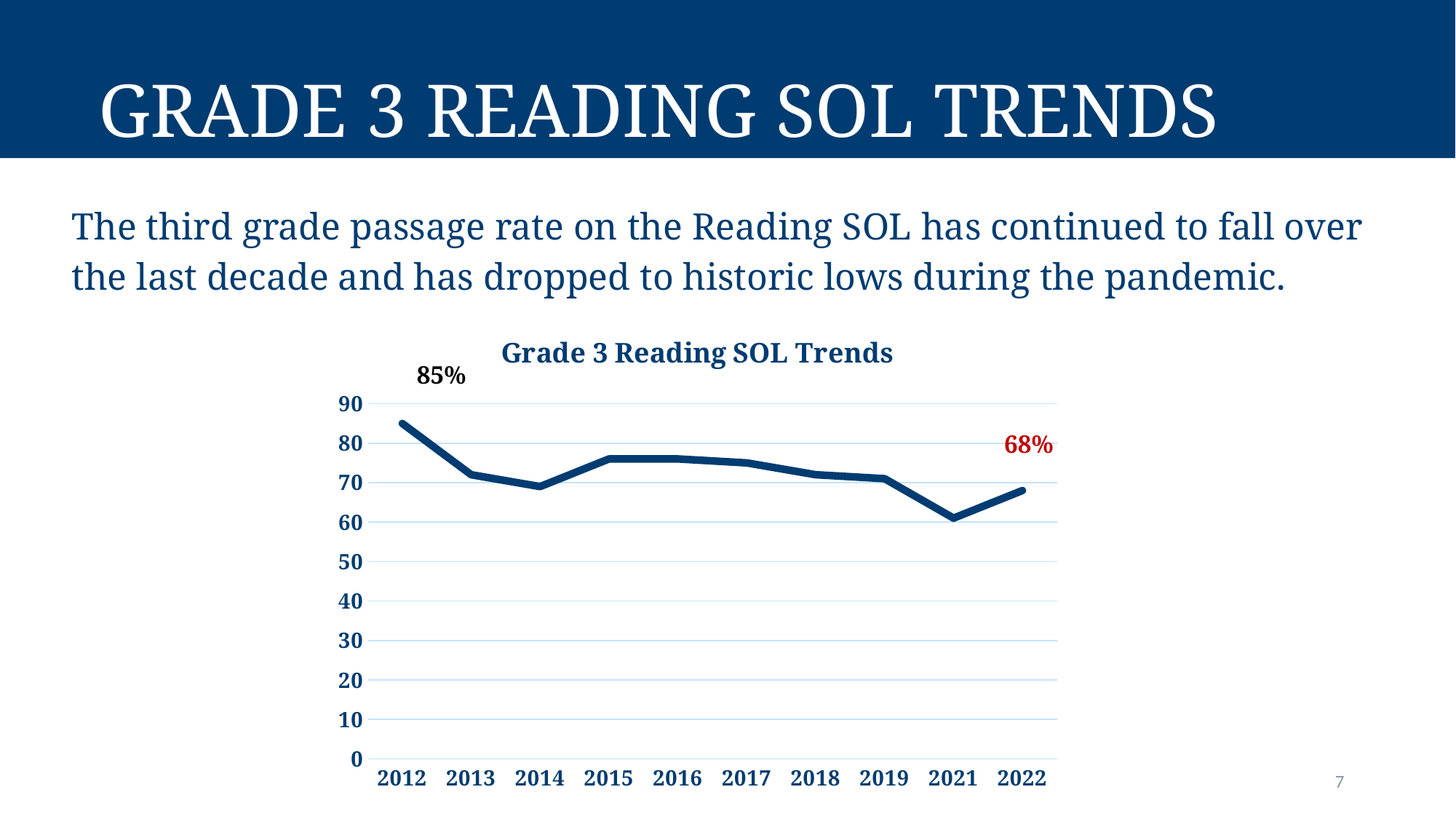
What is the difference between the 2012 value and the 2022 value? 17 percentage points Which is larger, the value for 2015 or the value for 2021? 2015 What is the value for 2012? 85% Is the value for 2015 greater or less than 70? greater Is the value for 2021 greater or less than 70? less Which year has the highest value? 2012 Overall, do the values rise or fall from 2012 to 2022? Fall Which year has the lowest value? 2021 What is the title of the chart? Grade 3 Reading SOL Trends How many years are plotted on the x axis? 10 What kind of chart is this? Line chart What is the value for 2022? 68%